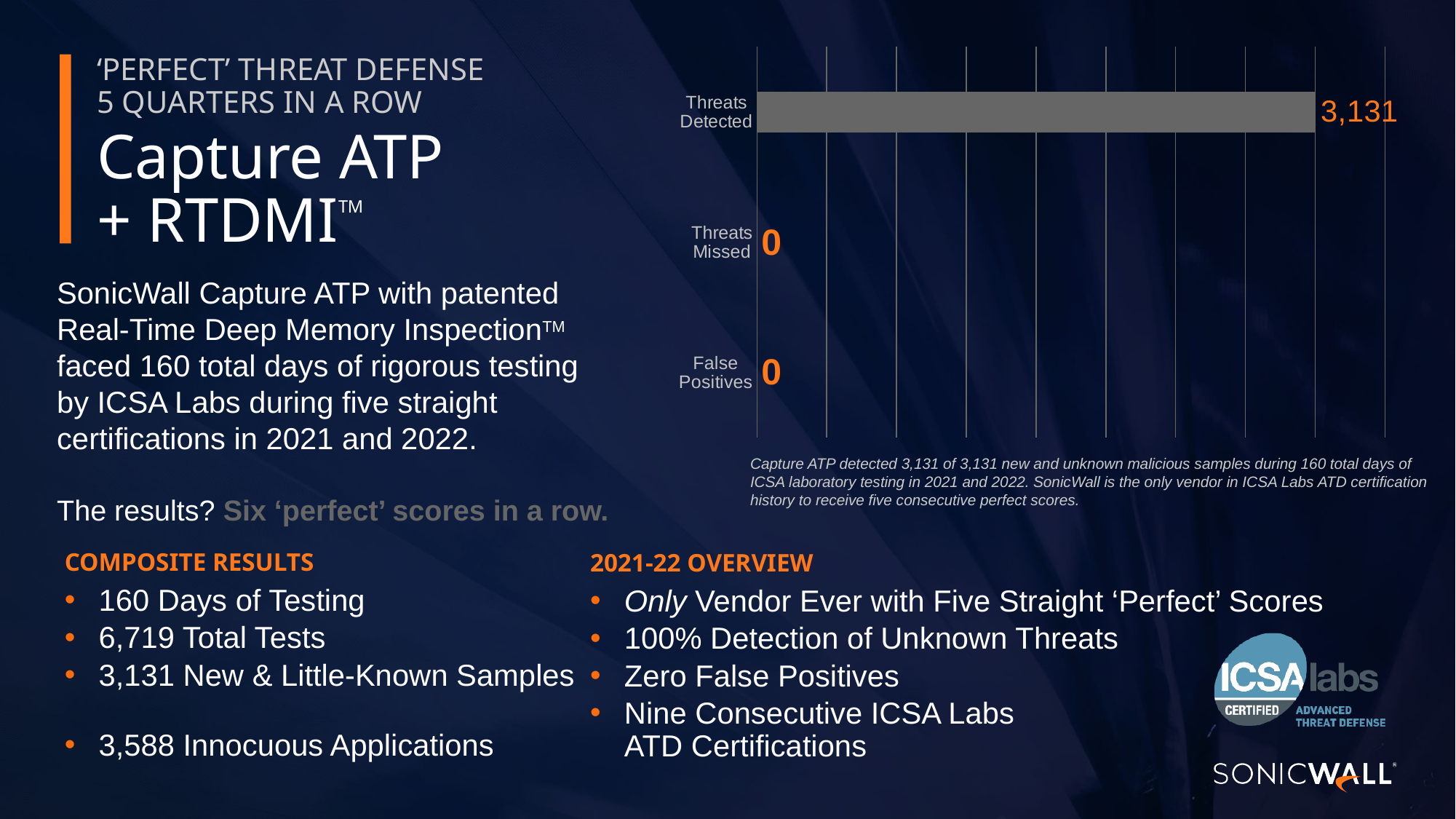
What colour is the Threats Detected bar? grey What is the value for Threats Missed? 0 Which category has the highest value? Threats Detected What is the difference between Threats Detected and Threats Missed? 3,131 What kind of chart is shown on the slide? bar chart Which is larger, Threats Detected or False Positives? Threats Detected What is the total of Threats Missed and False Positives? 0 What is the value for Threats Detected? 3,131 Are the bars in the chart horizontal or vertical? horizontal How many categories are shown in the chart? 3 What is the value for False Positives? 0